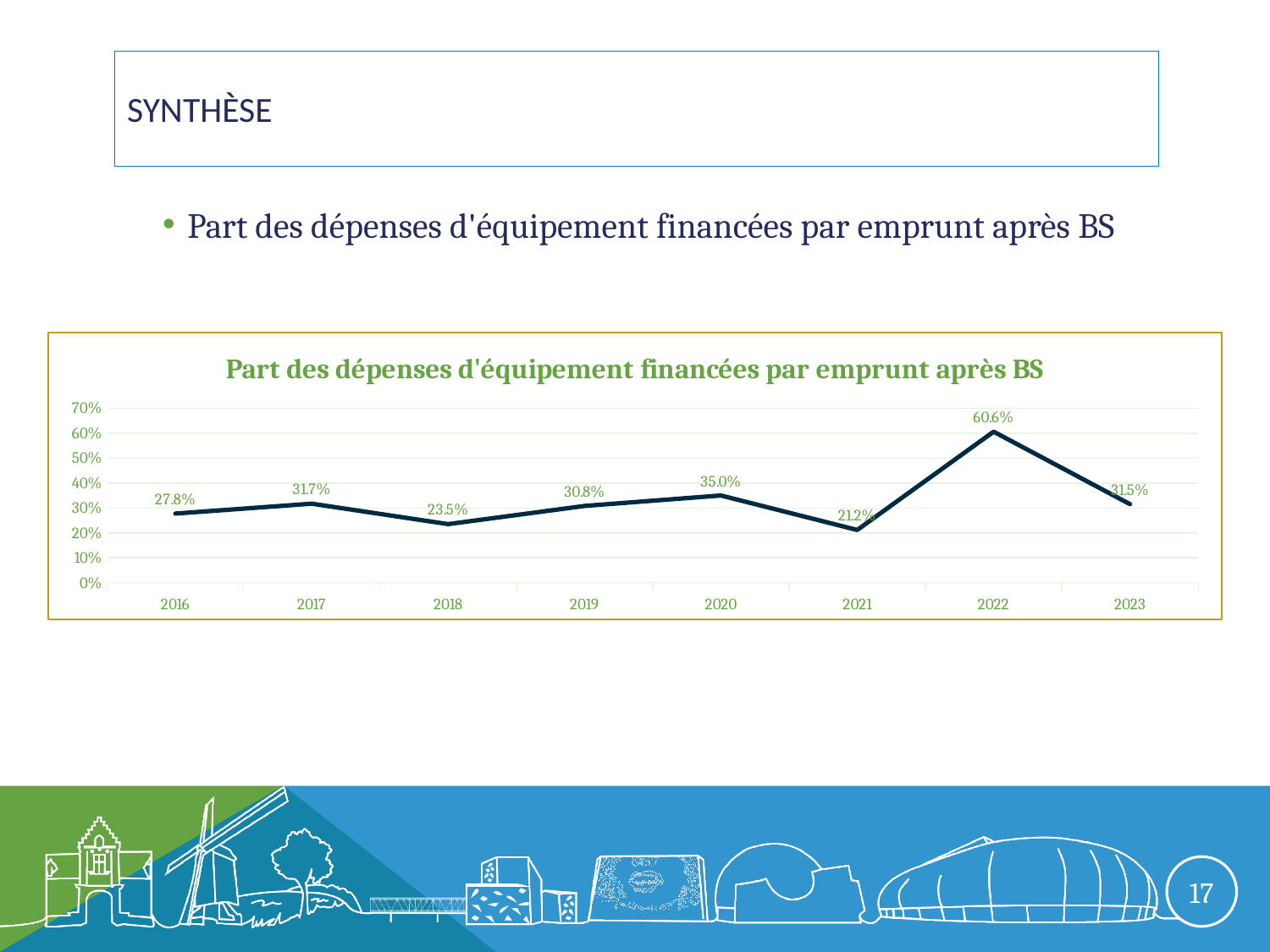
What is the value for 2022? 60.6% What is the difference between the values for 2022 and 2021? 39.4% Does the value rise or fall from 2022 to 2023? fall Is the value for 2022 greater or less than 50%? greater What is the value for 2018? 23.5% Which is larger, the value for 2017 or the value for 2019? 2017 What is the title of the chart? Part des dépenses d'équipement financées par emprunt après BS Which year has the highest value? 2022 What is the value for 2020? 35.0% How many years are plotted on the chart? 8 What kind of chart is shown? line chart Which year has the lowest value? 2021